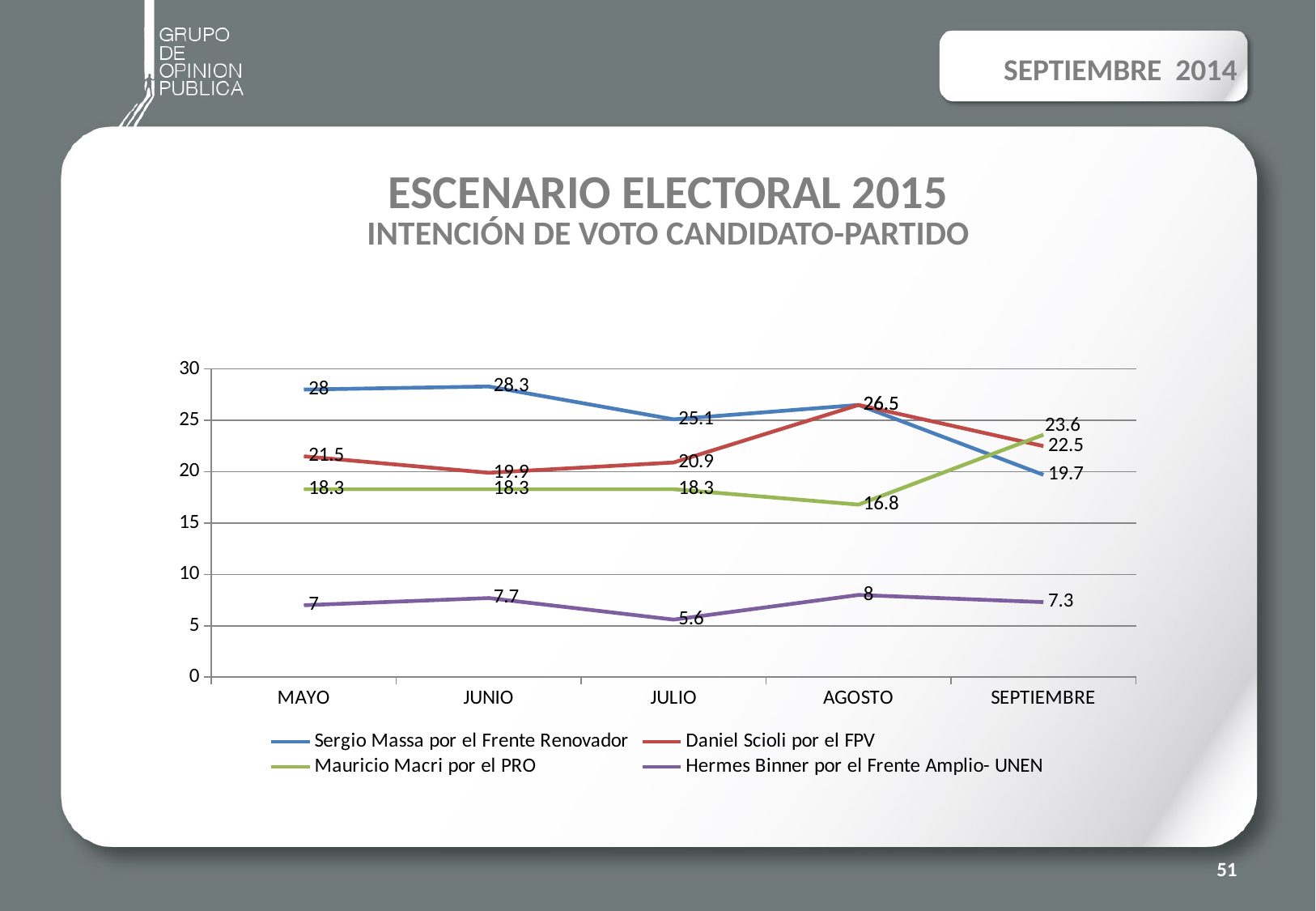
Does the value for Mauricio Macri por el PRO rise or fall from AGOSTO to SEPTIEMBRE? rise In SEPTIEMBRE, which is larger: the value for Mauricio Macri por el PRO or for Daniel Scioli por el FPV? Mauricio Macri por el PRO What is the value for Sergio Massa por el Frente Renovador in MAYO? 28 What is the difference between Sergio Massa's value in MAYO and in SEPTIEMBRE? 8.3 How many months are shown on the x axis? 5 What is the value for Hermes Binner por el Frente Amplio- UNEN in JULIO? 5.6 In which month does Sergio Massa por el Frente Renovador reach its highest value? JUNIO In which month does Hermes Binner por el Frente Amplio- UNEN have its lowest value? JULIO What is the value for Mauricio Macri por el PRO in SEPTIEMBRE? 23.6 How many series does the legend list? 4 What is the value for Daniel Scioli por el FPV in JUNIO? 19.9 What kind of chart is shown on the slide? line chart